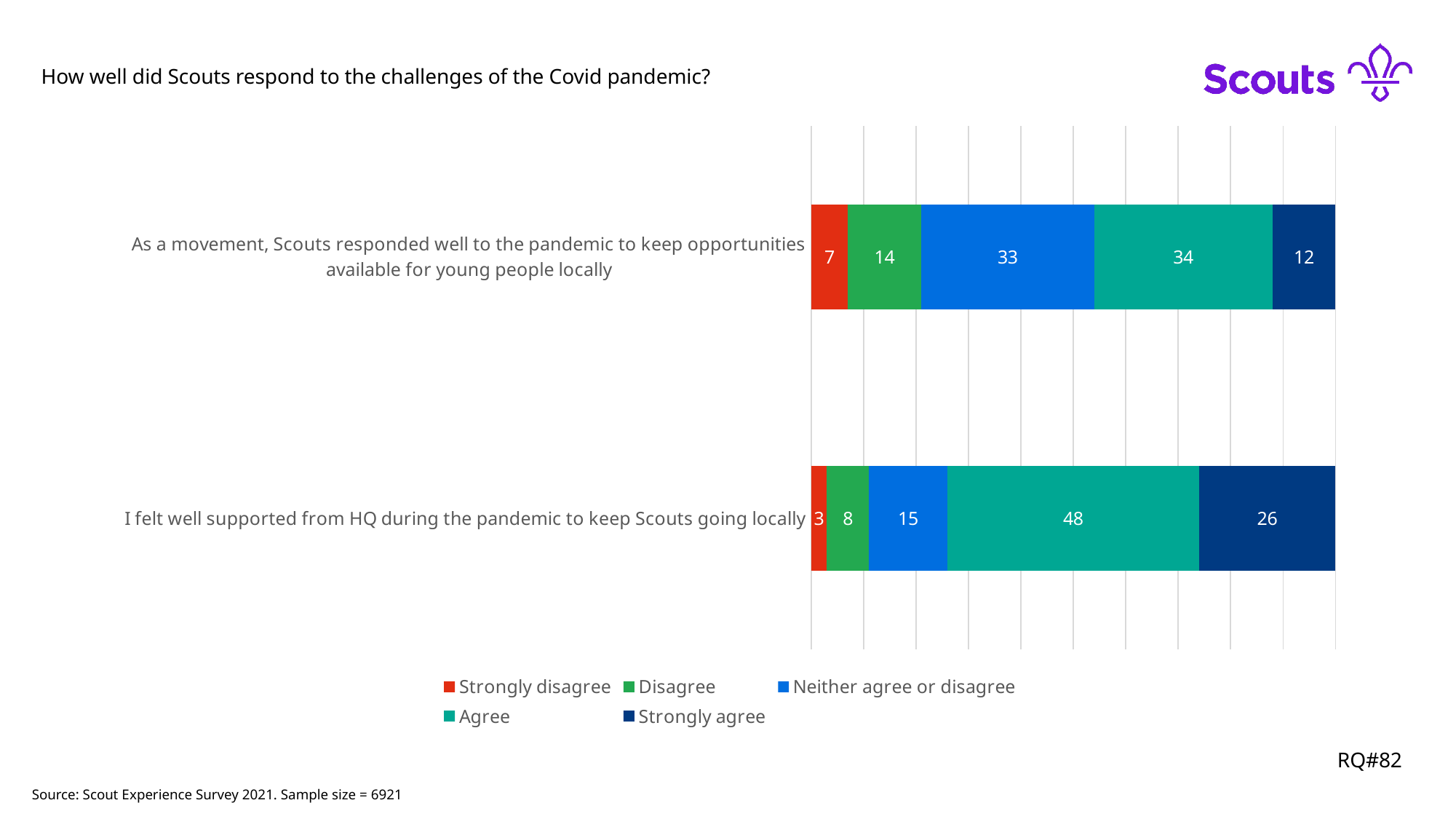
What is the difference between the 'Strongly agree' values for the two statements? 14 How many statements (bars) are shown in the chart? 2 Which response category has the largest value for 'I felt well supported from HQ during the pandemic to keep Scouts going locally'? Agree What is the 'Strongly agree' value for 'I felt well supported from HQ during the pandemic to keep Scouts going locally'? 26 What is the 'Agree' value for 'I felt well supported from HQ during the pandemic to keep Scouts going locally'? 48 What is the 'Strongly disagree' value for 'As a movement, Scouts responded well to the pandemic to keep opportunities available for young people locally'? 7 What is the total of the stacked bar for 'I felt well supported from HQ during the pandemic to keep Scouts going locally'? 100 How many series does the legend list? 5 Which response category has the smallest value for 'As a movement, Scouts responded well to the pandemic to keep opportunities available for young people locally'? Strongly disagree Which statement has the larger 'Disagree' value? As a movement, Scouts responded well to the pandemic to keep opportunities available for young people locally What is the 'Neither agree or disagree' value for 'As a movement, Scouts responded well to the pandemic to keep opportunities available for young people locally'? 33 What kind of chart is shown on the slide? Stacked bar chart